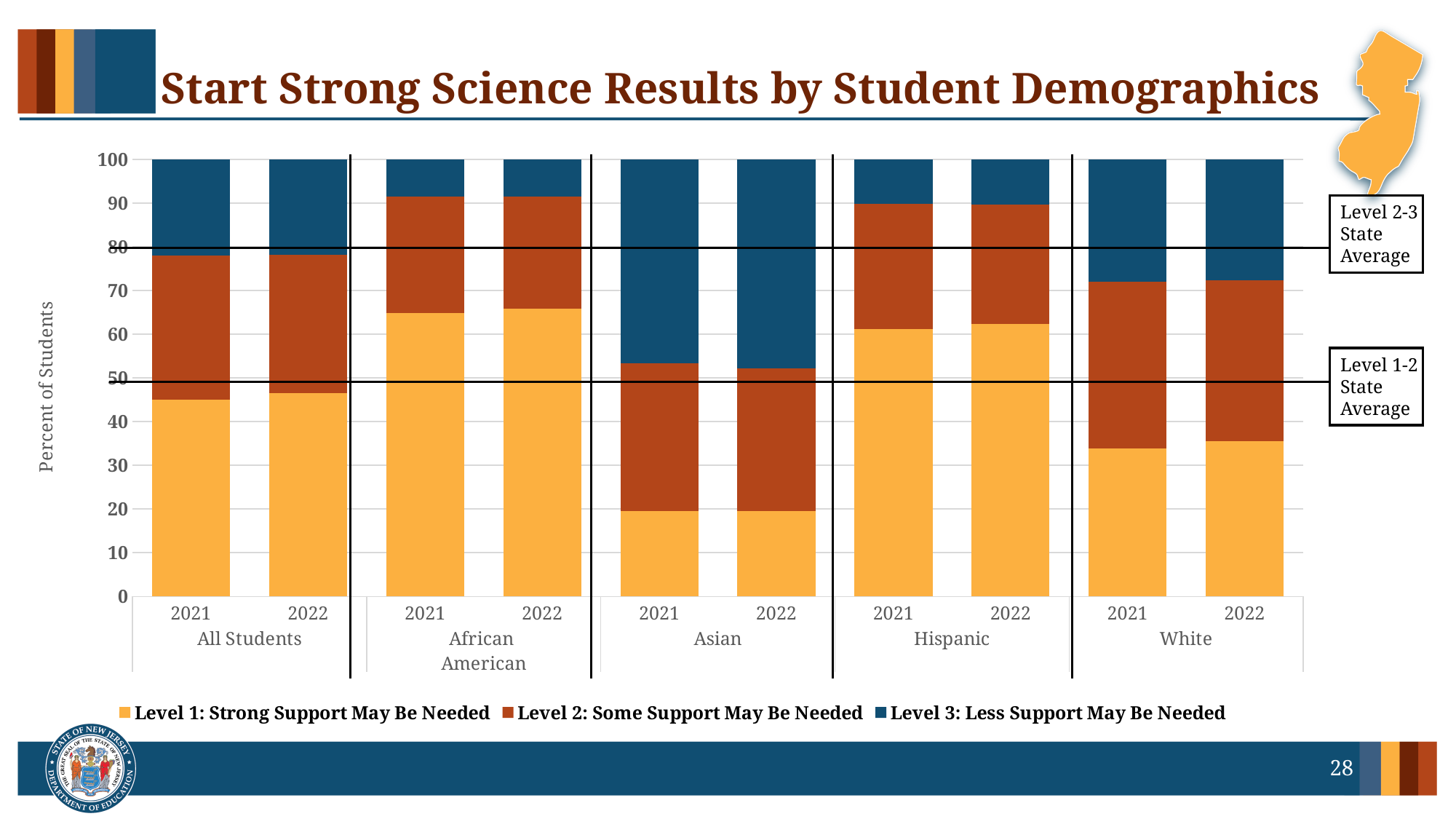
What kind of chart is shown on the slide? Stacked bar chart How many bars are plotted in the chart in total? 10 What is the title of the y axis? Percent of Students In 2021, which group has the larger Level 1 share, Hispanic or White? Hispanic Is the Level 3 value for Asian students in 2022 greater or less than 40? greater What is the total of the stacked bar for All Students in 2021? 100 How many series does the legend list? 3 How many student demographic groups are shown along the x axis? 5 Is the Level 1 value for African American students in 2022 greater or less than 60? greater Which demographic group has the smallest Level 1 share in 2021? Asian Which demographic group has the largest Level 1 share in 2022? African American Is the Level 1 value for Asian students in 2021 greater or less than 30? less